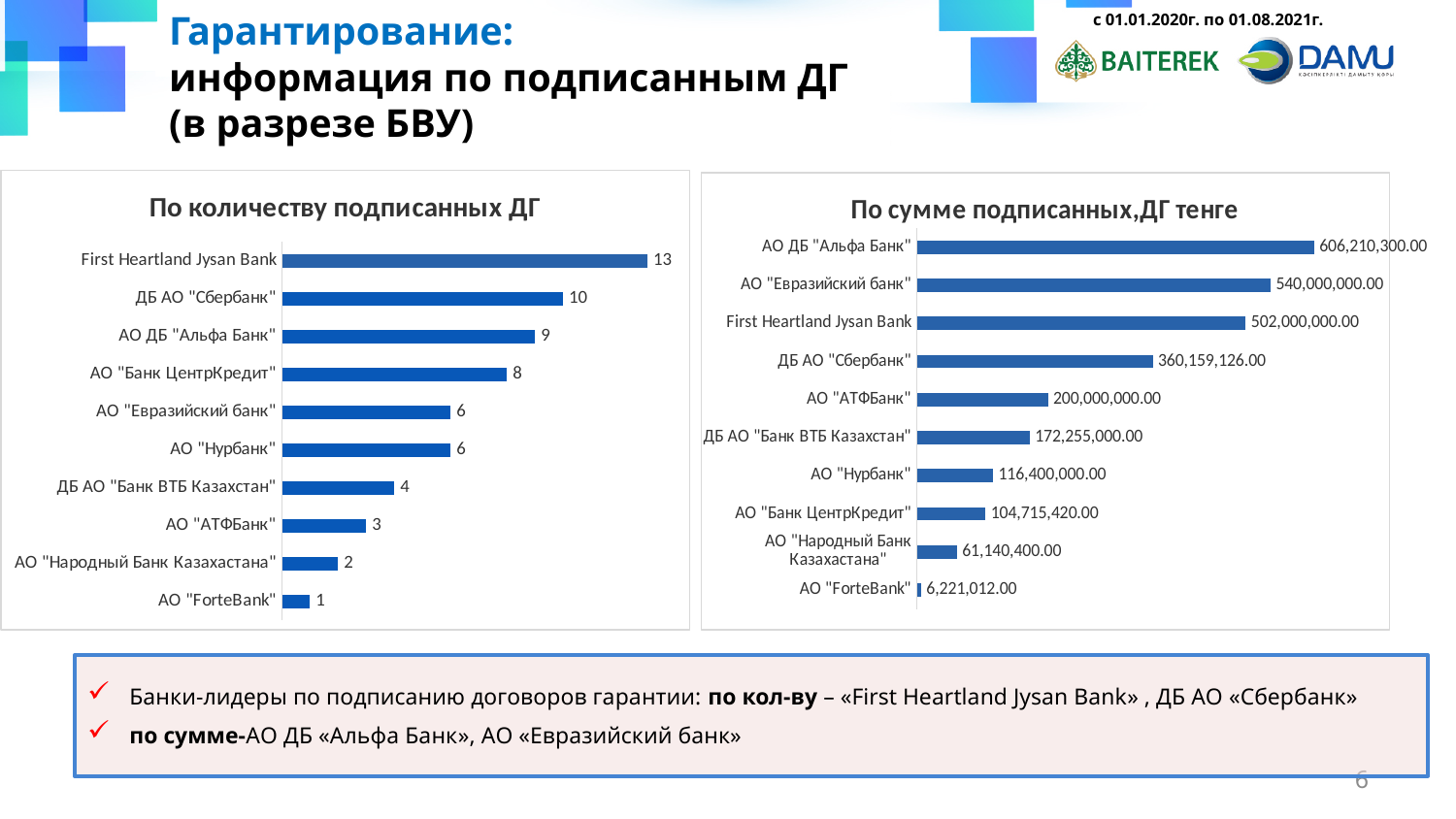
In the chart 'По сумме подписанных,ДГ тенге', what is the difference between АО ДБ "Альфа Банк" and АО "Евразийский банк"? 66,210,300.00 In the chart 'По количеству подписанных ДГ', which bank has the lowest value? АО "ForteBank" In the chart 'По количеству подписанных ДГ', what is the difference between First Heartland Jysan Bank and АО ДБ "Альфа Банк"? 4 In the chart 'По количеству подписанных ДГ', how many banks are shown? 10 In the chart 'По сумме подписанных,ДГ тенге', which is larger: the value for ДБ АО "Сбербанк" or the value for First Heartland Jysan Bank? First Heartland Jysan Bank In the chart 'По сумме подписанных,ДГ тенге', what is the value for АО "АТФБанк"? 200,000,000.00 In the chart 'По сумме подписанных,ДГ тенге', what is the value for АО "Народный Банк Казахастана"? 61,140,400.00 In the chart 'По количеству подписанных ДГ', what is the value for ДБ АО "Сбербанк"? 10 What type of chart is 'По количеству подписанных ДГ'? Bar chart In the chart 'По сумме подписанных,ДГ тенге', which bank has the highest value? АО ДБ "Альфа Банк" In the chart 'По сумме подписанных,ДГ тенге', which bank has the lowest value? АО "ForteBank" In the chart 'По количеству подписанных ДГ', which bank has the highest value? First Heartland Jysan Bank